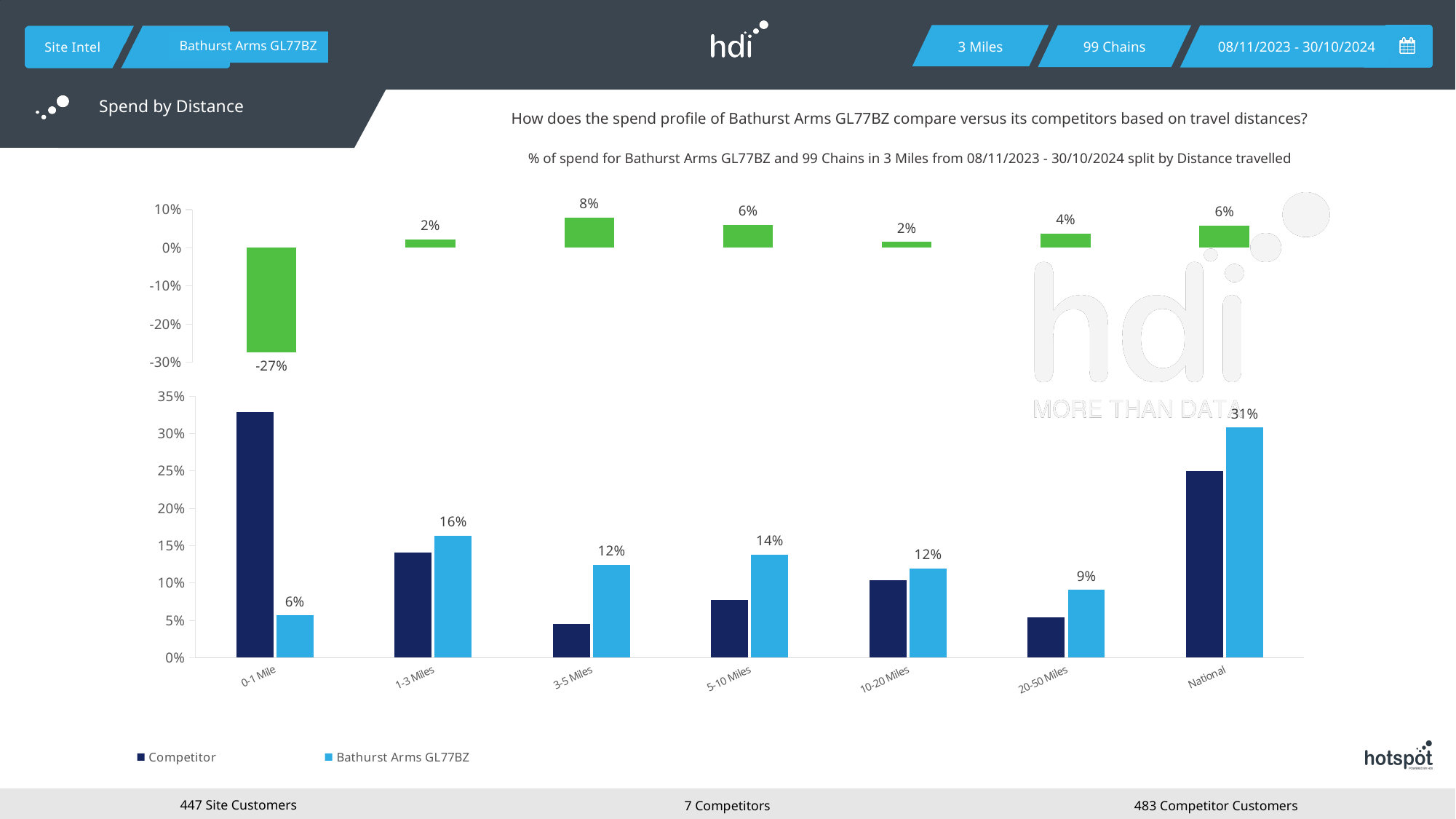
In the top chart (green bars), which category has the lowest value? 0-1 Mile In the bottom chart, what is the difference between the Bathurst Arms GL77BZ values for 5-10 Miles and 20-50 Miles? 5% What kind of chart is the bottom chart? Bar chart In the top chart (green bars), what is the value for 0-1 Mile? -27% How many distance categories are shown on the x axis of the bottom chart? 7 In the bottom chart, what is the value for Bathurst Arms GL77BZ at 1-3 Miles? 16% In the top chart (green bars), what is the value for 3-5 Miles? 8% In the bottom chart, is the Competitor value for 0-1 Mile greater or less than 30%? greater In the bottom chart, what is the value for Bathurst Arms GL77BZ at National? 31% In the top chart (green bars), which category has the highest value? 3-5 Miles How many series does the legend of the bottom chart list? 2 In the bottom chart, which is larger at 0-1 Mile: Competitor or Bathurst Arms GL77BZ? Competitor